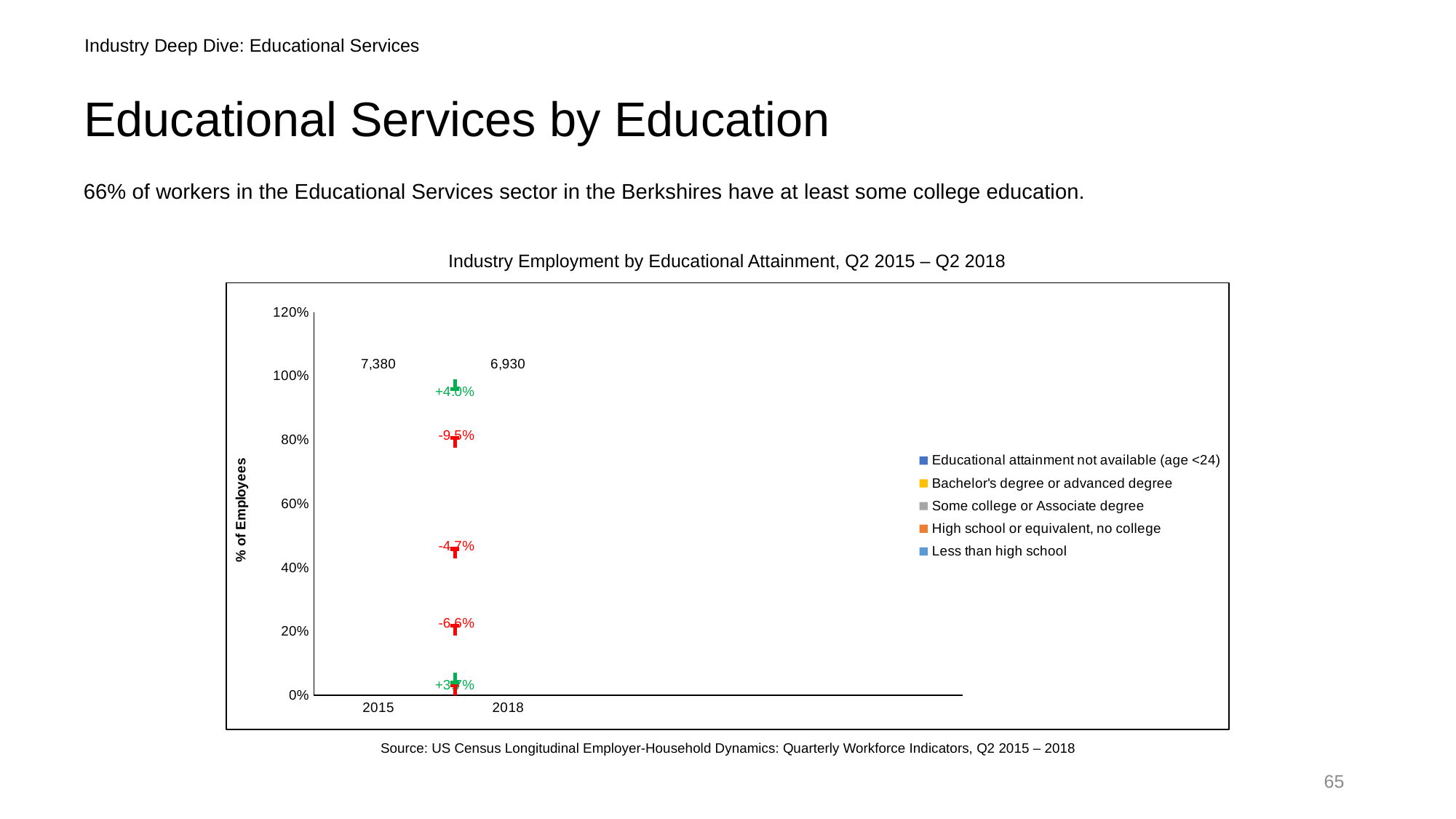
What is the label on the y axis of the chart? % of Employees Which year has the larger total employment label, 2015 or 2018? 2015 What is the title of the chart? Industry Employment by Educational Attainment, Q2 2015 – Q2 2018 What is the difference between the 2015 total (7,380) and the 2018 total (6,930)? 450 Which legend entry is listed first in the chart? Educational attainment not available (age <24) What total employment figure is labelled above the 2015 column in the chart? 7,380 How many years are shown on the x axis of the chart? 2 What is the topmost percentage-change label shown between the two columns in the chart? +4.0% Did total employment in the chart rise or fall from 2015 to 2018? fall How many series does the chart's legend list? 5 What is the highest value shown on the y axis of the chart? 120% What total employment figure is labelled above the 2018 column in the chart? 6,930